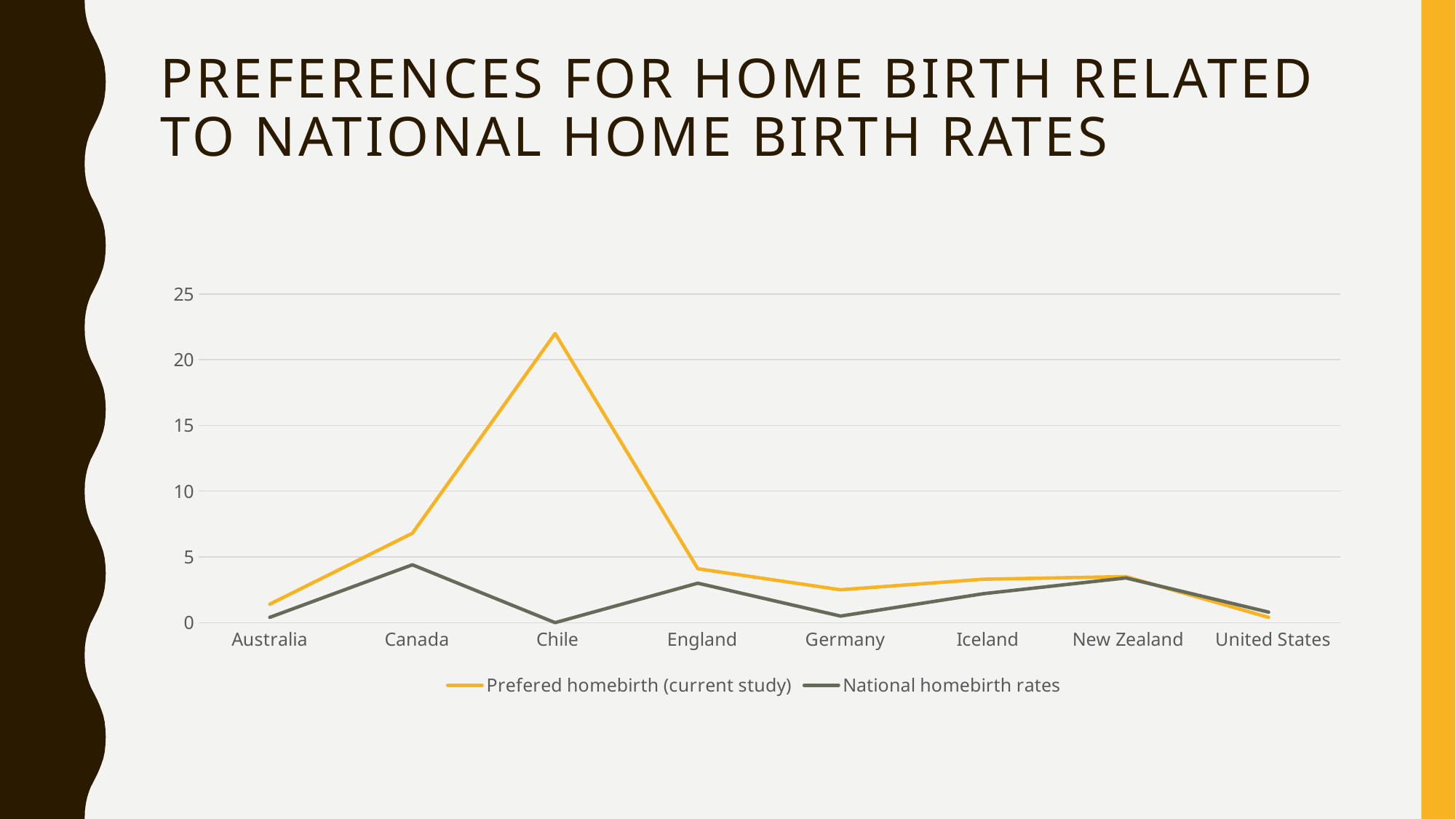
How many series does the legend list? 2 Does the Prefered homebirth (current study) line rise or fall from Chile to Germany? fall How many countries are shown on the x axis? 8 Which country has the highest value for Prefered homebirth (current study)? Chile What colour is the line for Prefered homebirth (current study)? yellow/orange Which country has the highest value for National homebirth rates? Canada What kind of chart is shown on the slide? line chart Is the Prefered homebirth (current study) value for Canada greater or less than 5? greater Is the National homebirth rates value for Chile greater or less than 5? less Is the Prefered homebirth (current study) value for Chile greater or less than 20? greater Which country has the lowest value for Prefered homebirth (current study)? United States For Chile, which series has the larger value: Prefered homebirth (current study) or National homebirth rates? Prefered homebirth (current study)